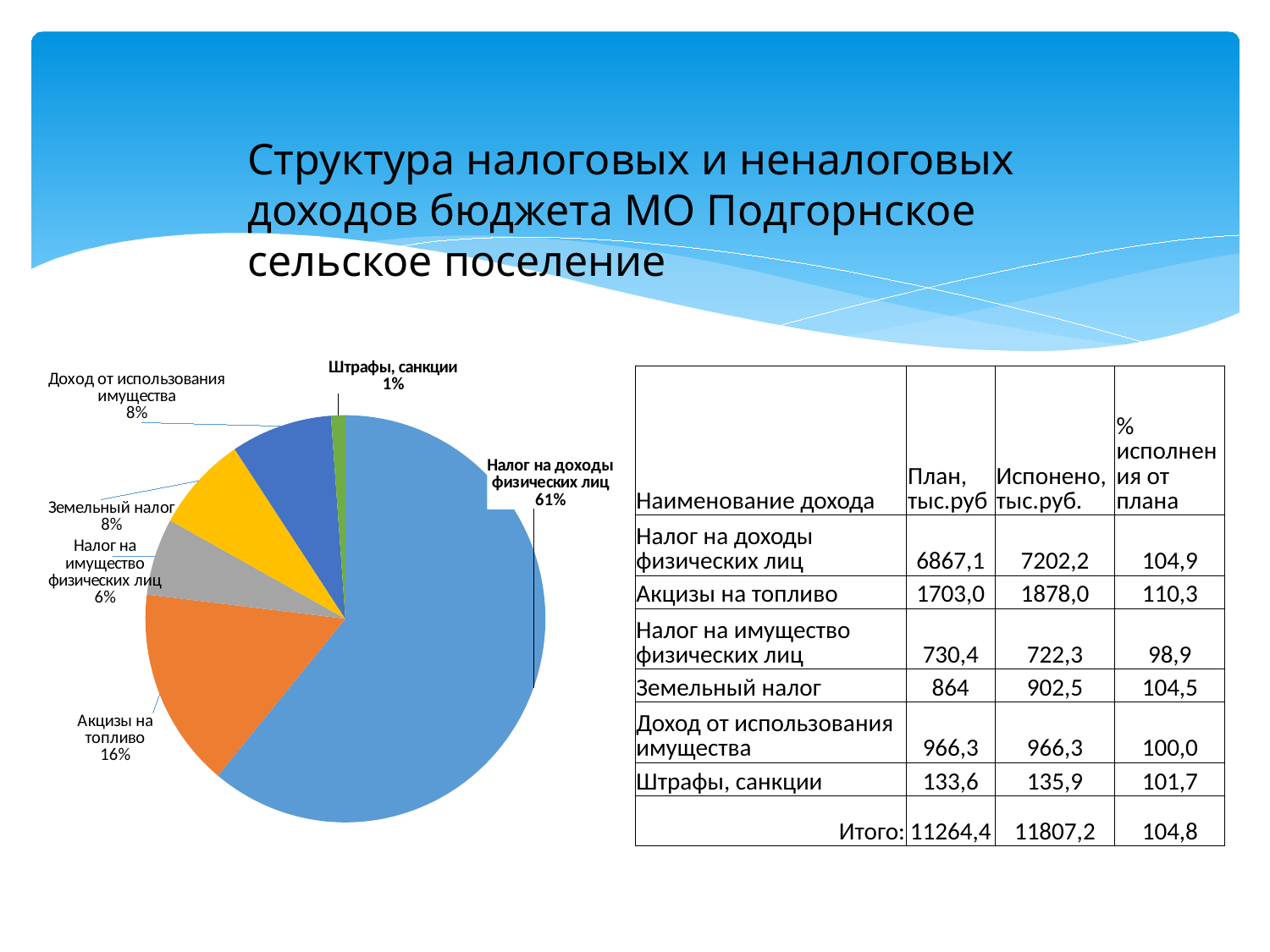
Which category has the largest slice of the pie? Налог на доходы физических лиц What share of the pie does "Акцизы на топливо" represent? 16% What share of the pie does "Штрафы, санкции" represent? 1% What share of the pie does "Налог на доходы физических лиц" represent? 61% Which category has the smallest slice of the pie? Штрафы, санкции How many slices does the pie chart have? 6 What colour is the "Акцизы на топливо" slice in the pie chart? Orange What is the difference in percentage points between the "Налог на доходы физических лиц" slice and the "Акцизы на топливо" slice? 45 Which slice is larger: "Акцизы на топливо" or "Доход от использования имущества"? Акцизы на топливо What kind of chart is shown on the slide? Pie chart